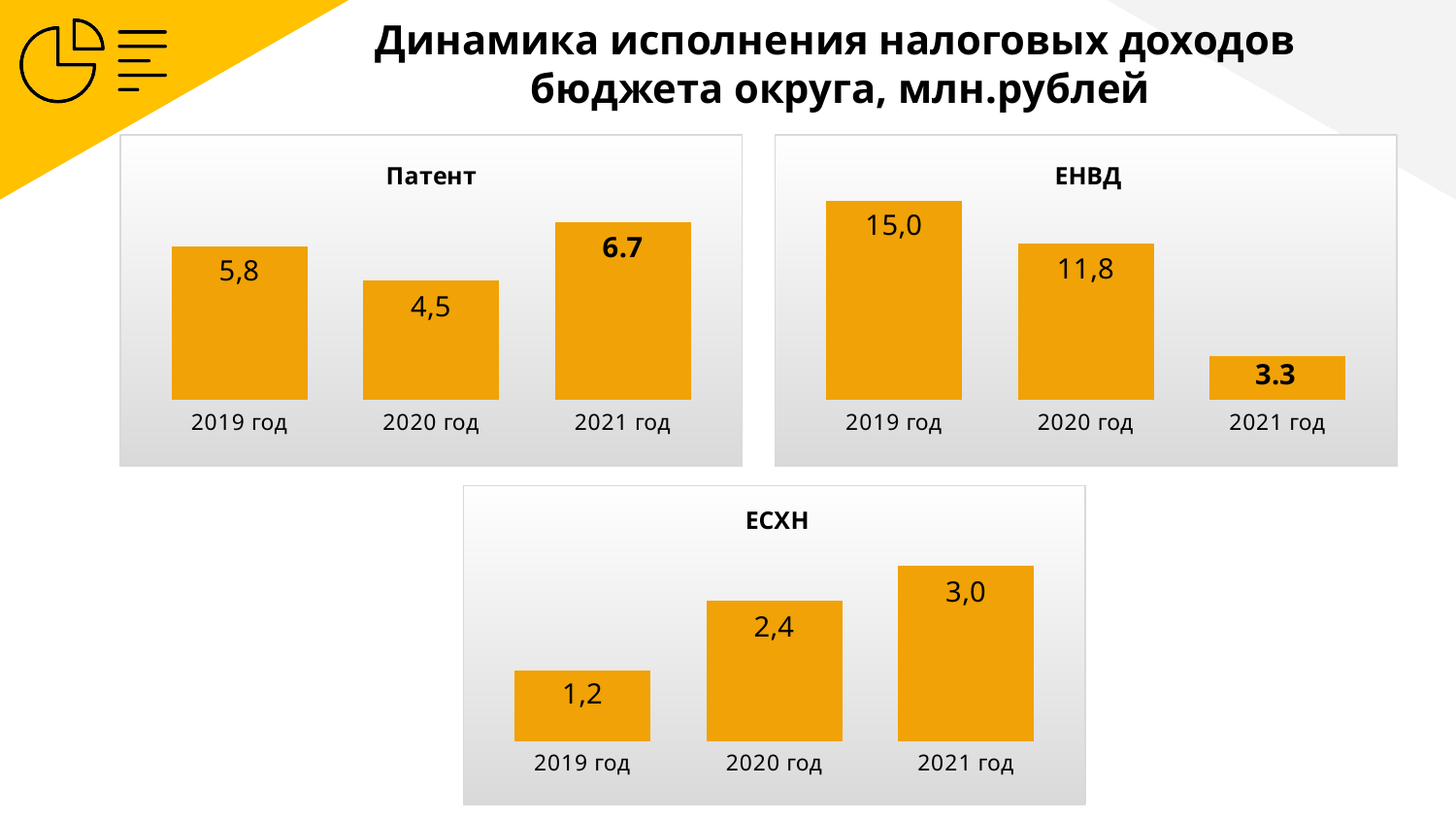
In the ЕНВД chart, what is the value for 2019 год? 15,0 In the ЕСХН chart, which year has the highest value? 2021 год In the Патент chart, what is the difference between the values for 2019 год and 2020 год? 1,3 In the ЕНВД chart, which year has the highest value? 2019 год In the Патент chart, what is the value for 2021 год? 6.7 In the ЕНВД chart, what is the difference between the values for 2019 год and 2020 год? 3,2 In the ЕСХН chart, do the values rise or fall from 2019 год to 2021 год? rise In the Патент chart, which year has the lowest value? 2020 год In the ЕНВД chart, what is the value for 2021 год? 3.3 In the Патент chart, what is the value for 2020 год? 4,5 In the ЕСХН chart, what is the value for 2020 год? 2,4 How many charts are shown on the slide? 3